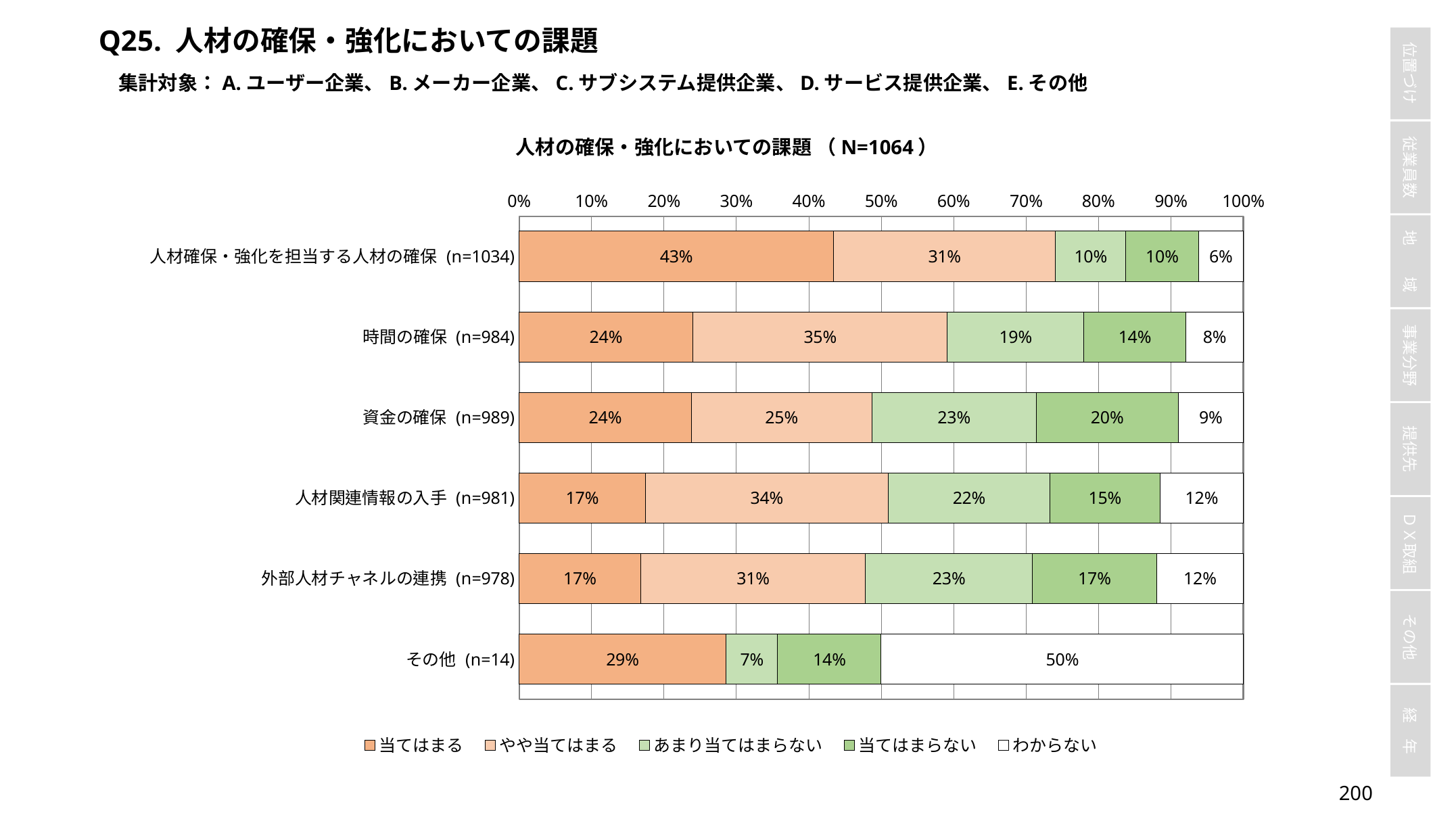
How many series does the legend list? 5 Which has a larger 当てはまらない value: 資金の確保 or 時間の確保? 資金の確保 What is the title of the chart? 人材の確保・強化においての課題（N=1064） What is the value of わからない for その他? 50% What is the value of 当てはまる for 人材確保・強化を担当する人材の確保? 43% How many categories are shown on the chart? 6 For 時間の確保, what is the difference between やや当てはまる and 当てはまる? 11 percentage points Which category has the highest 当てはまらない value? 資金の確保 What kind of chart is shown? Stacked bar chart What is the value of あまり当てはまらない for 外部人材チャネルの連携? 23% Which category has the lowest わからない value? 人材確保・強化を担当する人材の確保 Which category has the highest 当てはまる value? 人材確保・強化を担当する人材の確保